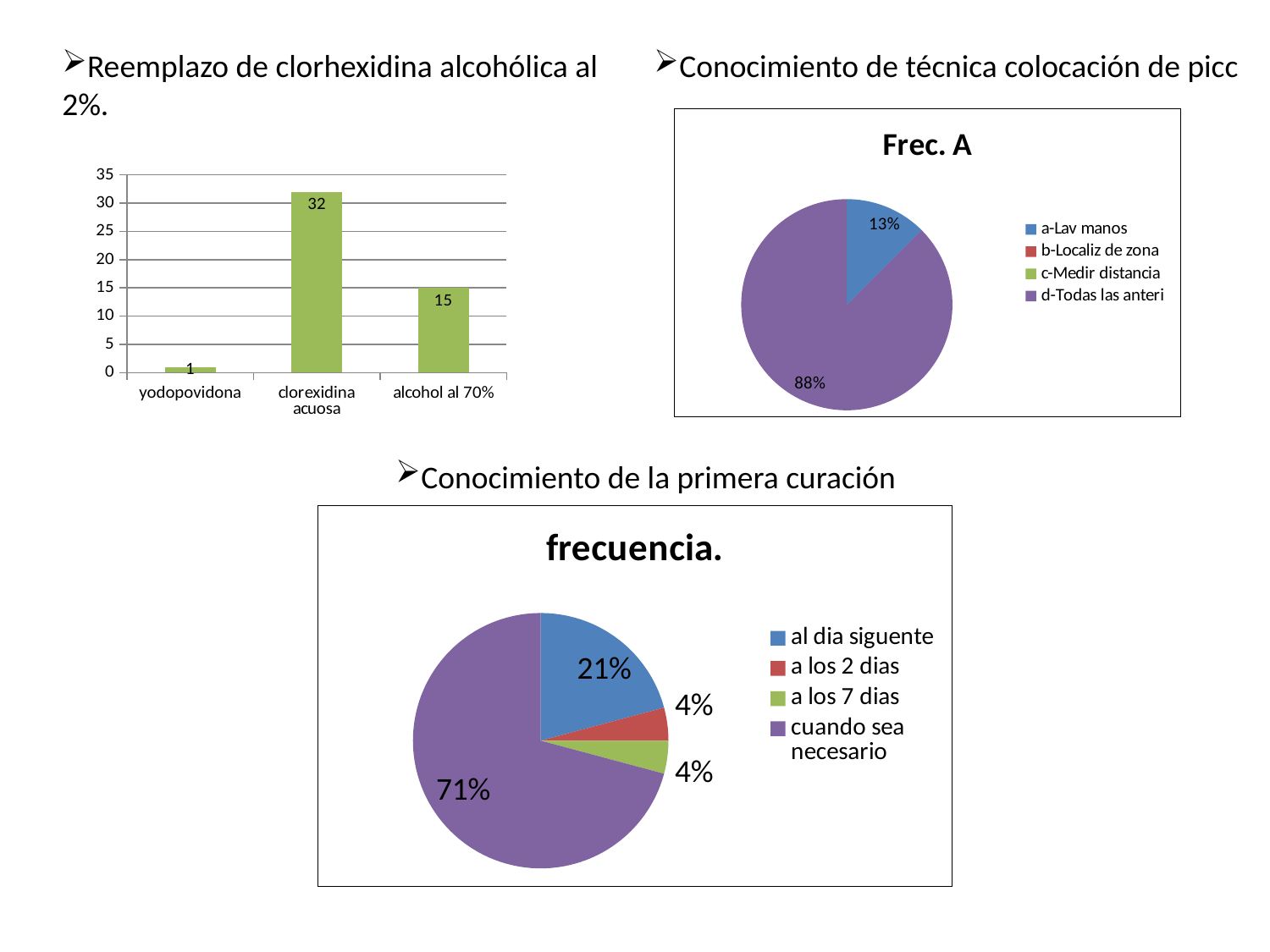
In the bar chart at the top left of the slide, what is the value for alcohol al 70%? 15 In the pie chart titled 'Frec. A', what share does a-Lav manos have? 13% In the bar chart at the top left of the slide, what is the difference between the values for clorexidina acuosa and alcohol al 70%? 17 What kind of chart is the chart at the top left of the slide? bar chart In the bar chart at the top left of the slide, which category has the highest value? clorexidina acuosa In the bar chart at the top left of the slide, which category has the lowest value? yodopovidona In the bar chart at the top left of the slide, what is the value for clorexidina acuosa? 32 In the bar chart at the top left of the slide, how many categories are shown on the x axis? 3 In the pie chart titled 'Frec. A', what share does d-Todas las anteri have? 88% How many entries does the legend of the pie chart titled 'Frec. A' list? 4 In the pie chart titled 'frecuencia.', which category has the largest slice? cuando sea necesario In the pie chart titled 'frecuencia.', what share does 'al dia siguente' have? 21%